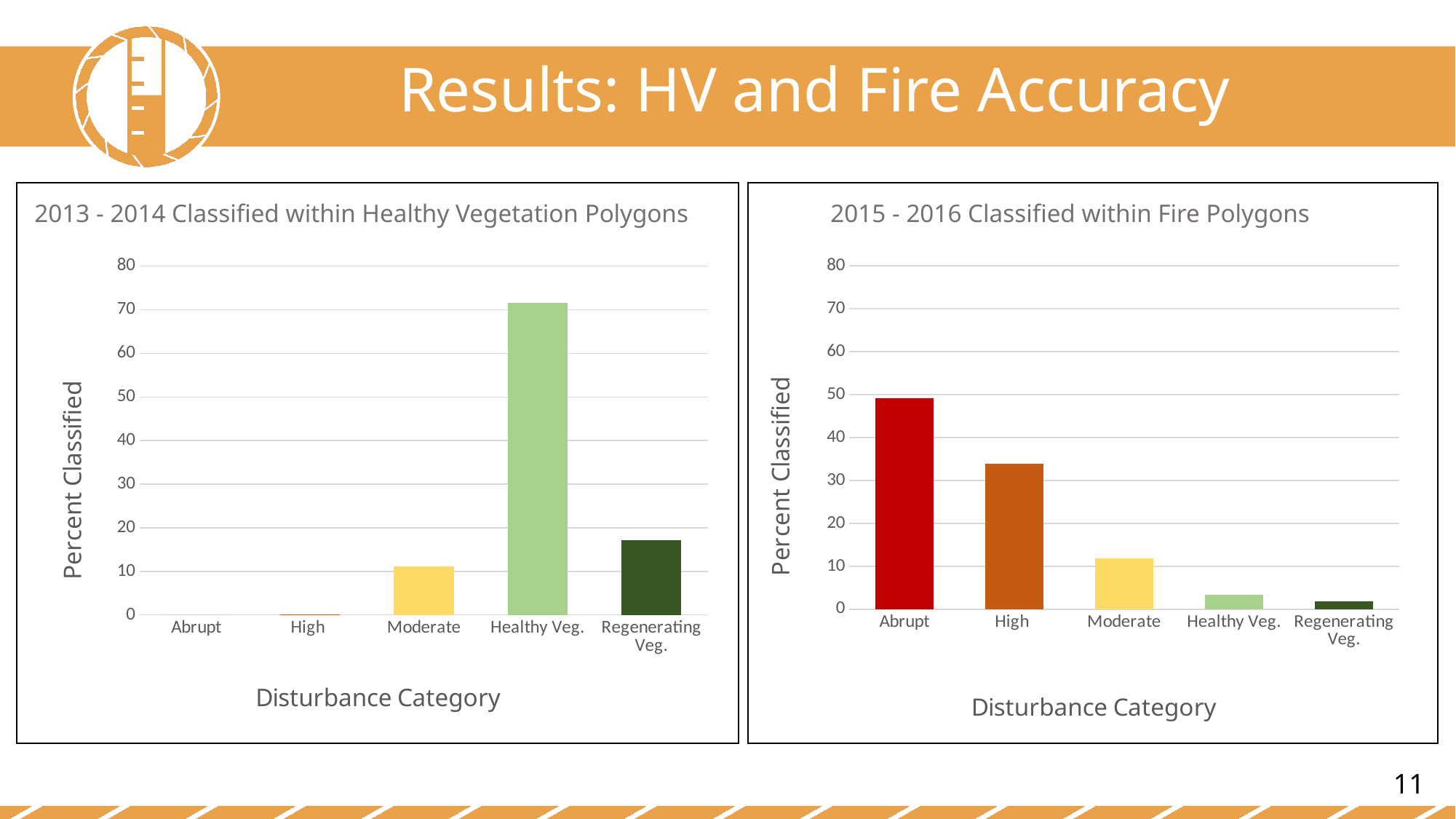
How many disturbance categories are shown on the x axis of the chart titled '2015 - 2016 Classified within Fire Polygons'? 5 In the left chart (2013 - 2014 Healthy Vegetation Polygons), is the value for Regenerating Veg. greater or less than 20? less In the chart titled '2013 - 2014 Classified within Healthy Vegetation Polygons', which disturbance category has the highest percent classified? Healthy Veg. In the right chart (2015 - 2016 Fire Polygons), is the value for High greater or less than 30? greater In the right chart (2015 - 2016 Fire Polygons), is the value for Healthy Veg. greater or less than 10? less What type of chart is the one titled '2013 - 2014 Classified within Healthy Vegetation Polygons'? Bar chart In the left chart (2013 - 2014 Healthy Vegetation Polygons), which is larger, the value for Moderate or the value for Regenerating Veg.? Regenerating Veg. In the chart titled '2015 - 2016 Classified within Fire Polygons', which disturbance category has the highest percent classified? Abrupt In the right chart (2015 - 2016 Fire Polygons), which is larger, the value for Abrupt or the value for High? Abrupt